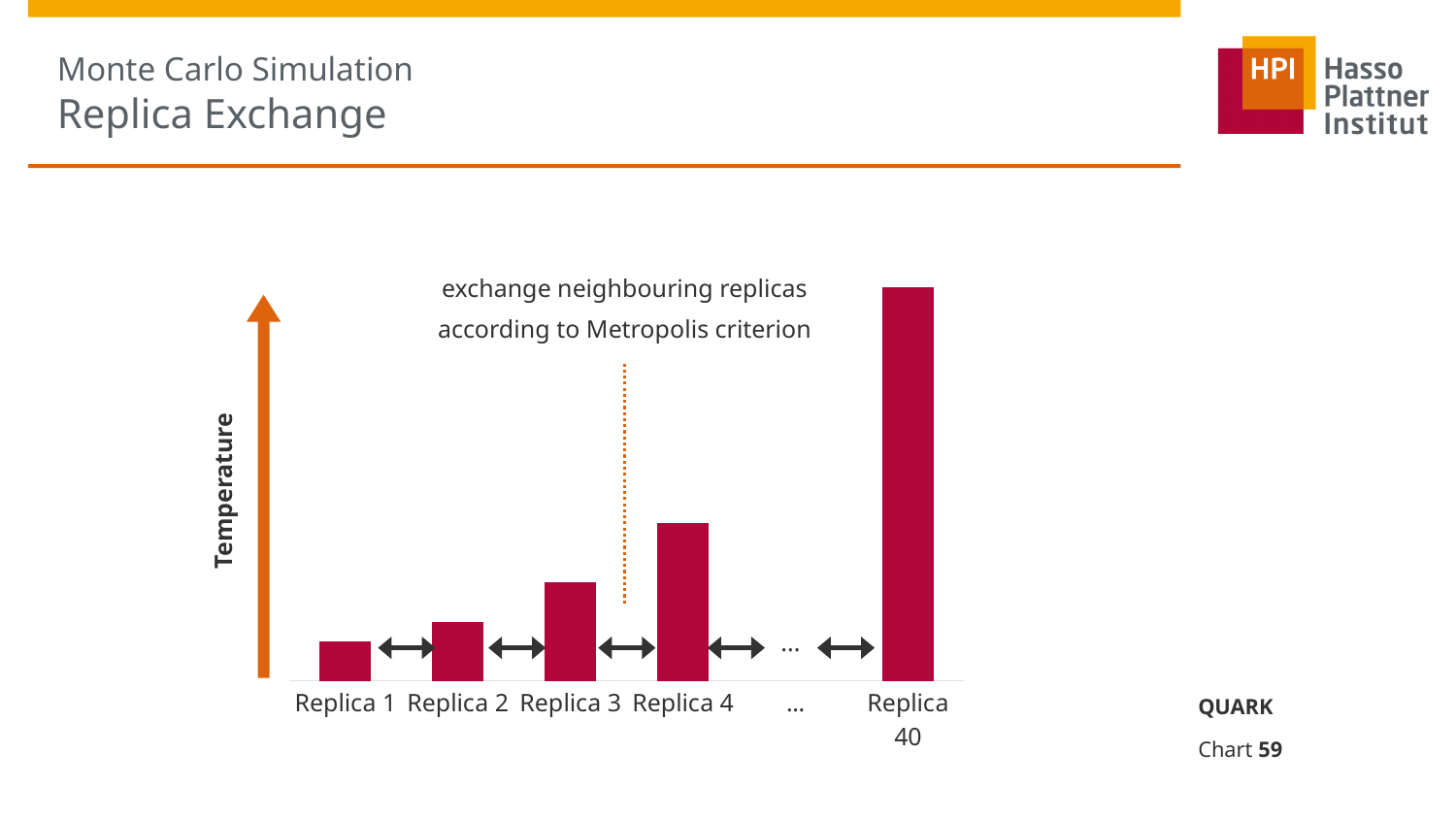
What quantity does the vertical axis represent? Temperature How many labelled replica categories are shown on the x axis (excluding the ellipsis)? 5 What colour are the bars in the chart? dark red Which replica has the lowest bar? Replica 1 Do the bar heights rise or fall from Replica 1 to Replica 40? rise Which has a lower bar, Replica 3 or Replica 1? Replica 1 How many bars are plotted in the chart? 5 Which replica has the highest bar? Replica 40 What kind of chart is shown on the slide? bar chart Which has a higher bar, Replica 2 or Replica 4? Replica 4